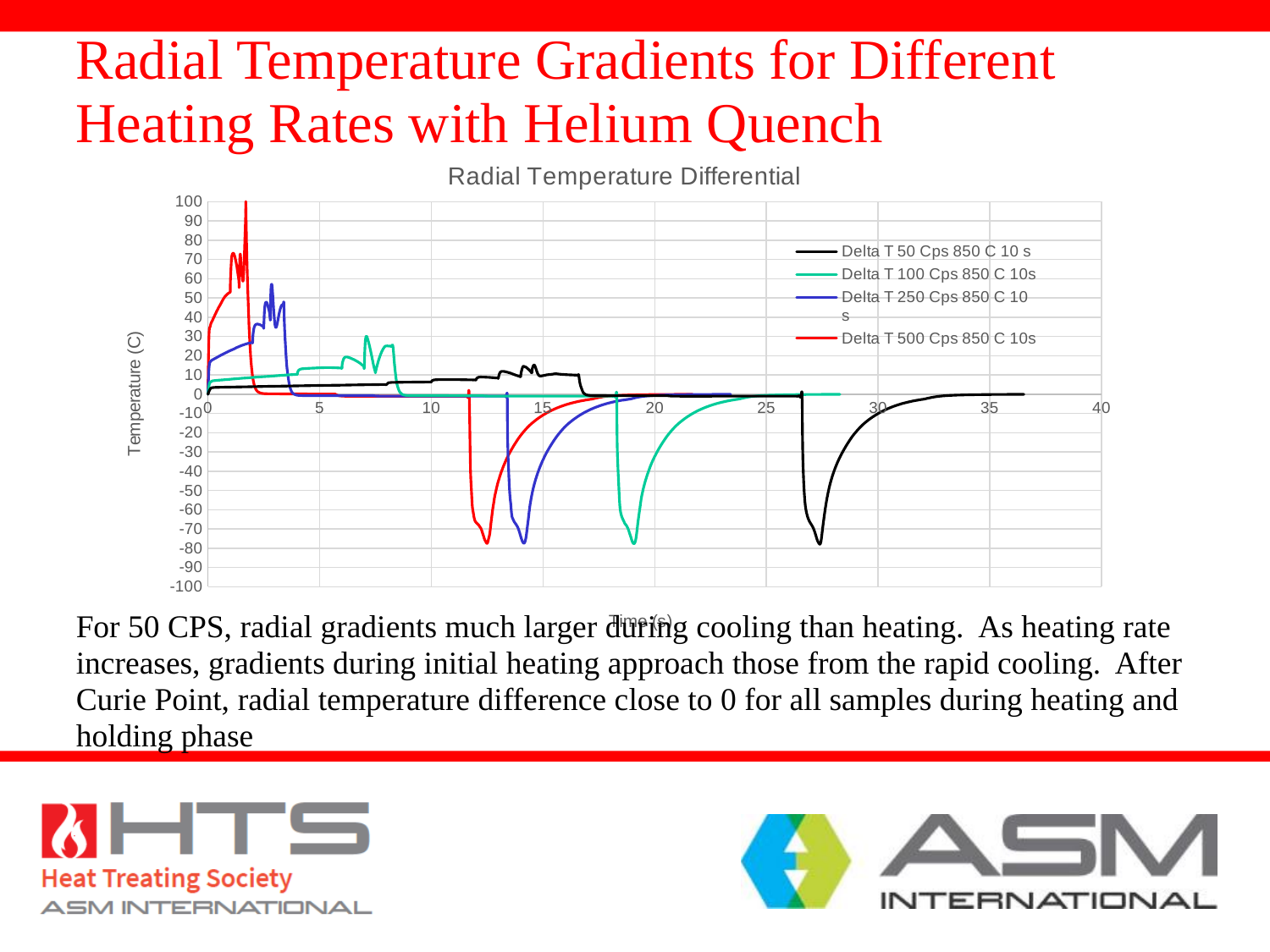
Is the peak value of the Delta T 100 Cps 850 C 10s series greater or less than 20? greater Is the peak value of the Delta T 50 Cps 850 C 10 s series during heating greater or less than 20? less What kind of chart is shown on the slide? Line chart Is the peak value of the Delta T 250 Cps 850 C 10 s series greater or less than 50? greater What is the title of the chart? Radial Temperature Differential Which series has a higher peak during heating: Delta T 250 Cps 850 C 10 s or Delta T 100 Cps 850 C 10s? Delta T 250 Cps 850 C 10 s How many series does the legend of the chart list? 4 Which series reaches the highest peak temperature differential during heating? Delta T 500 Cps 850 C 10s Which series shows its cooling dip latest in time on the x axis? Delta T 50 Cps 850 C 10 s Which colour is used for the Delta T 500 Cps 850 C 10s series? Red